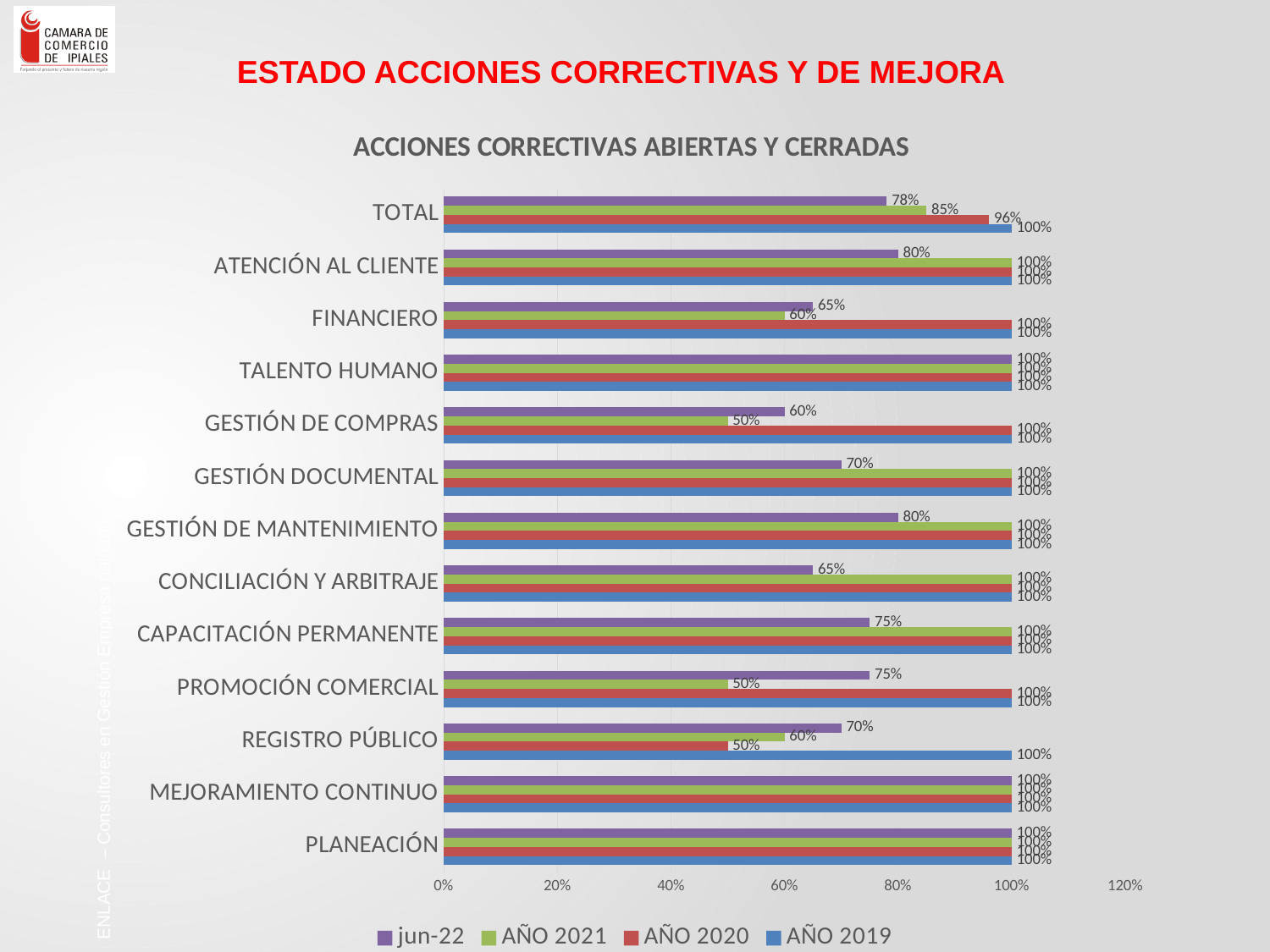
What is the jun-22 value for TOTAL? 78% How many series does the legend list? 4 What is the difference between the AÑO 2019 and jun-22 values for TOTAL? 22% What is the jun-22 value for CAPACITACIÓN PERMANENTE? 75% Which category has the lowest jun-22 value? GESTIÓN DE COMPRAS What kind of chart is shown? Bar chart What is the difference between the jun-22 and AÑO 2021 values for PROMOCIÓN COMERCIAL? 25% What is the AÑO 2021 value for GESTIÓN DE COMPRAS? 50% What is the AÑO 2021 value for FINANCIERO? 60% What is the AÑO 2020 value for REGISTRO PÚBLICO? 50% How many categories are shown on the y axis? 13 Which is larger for FINANCIERO, the jun-22 value or the AÑO 2021 value? jun-22